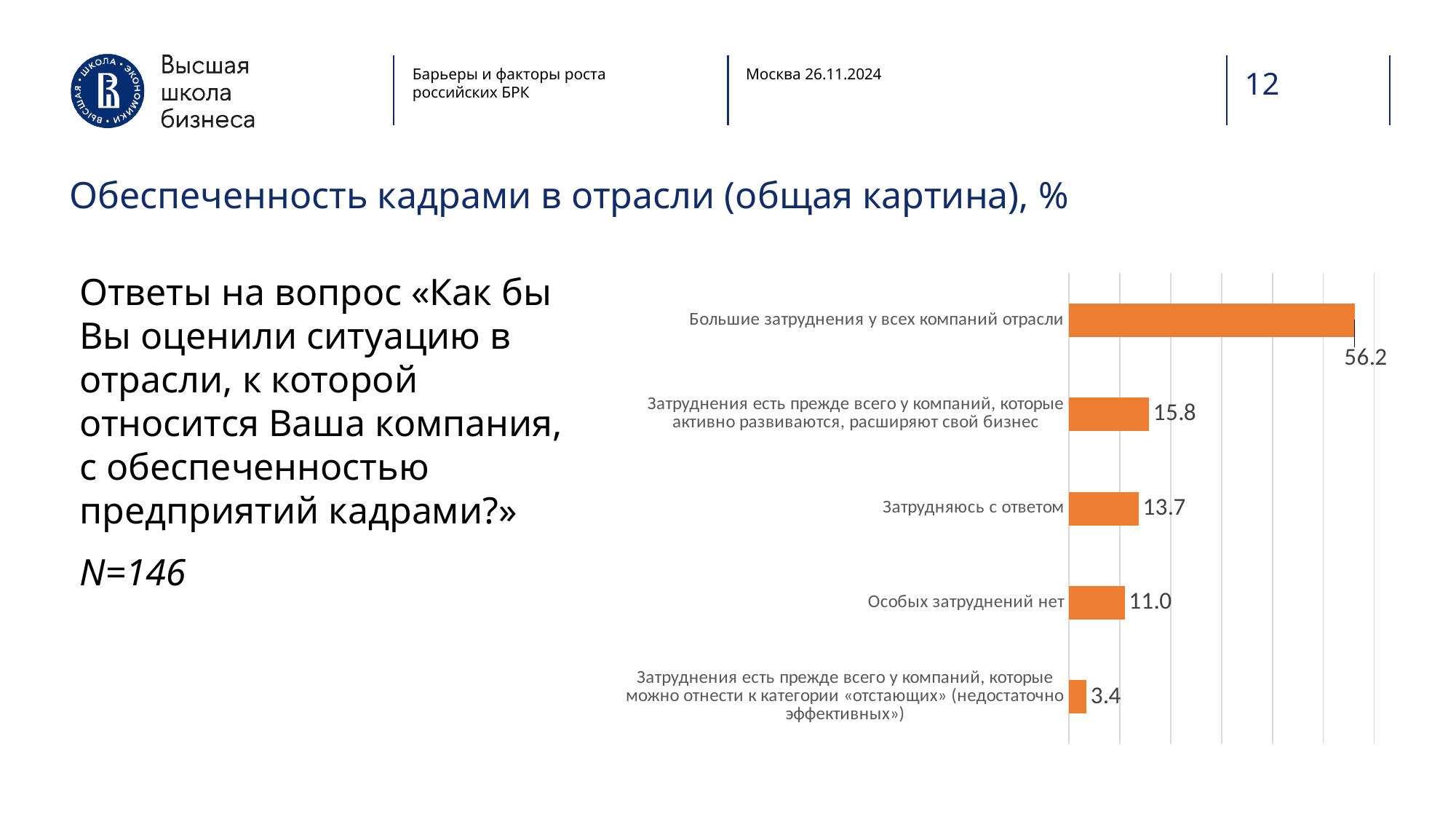
Which category has the highest value? Большие затруднения у всех компаний отрасли What is the difference between the values for «Затрудняюсь с ответом» and «Затруднения есть прежде всего у компаний, которые можно отнести к категории «отстающих» (недостаточно эффективных)»? 10.3 What kind of chart is shown on the slide? Bar chart What is the value for «Затрудняюсь с ответом»? 13.7 What is the sample size (N) stated on the slide? N=146 What is the value for «Большие затруднения у всех компаний отрасли»? 56.2 What is the difference between the values for «Большие затруднения у всех компаний отрасли» and «Особых затруднений нет»? 45.2 What is the value for «Особых затруднений нет»? 11.0 Which category has the lowest value? Затруднения есть прежде всего у компаний, которые можно отнести к категории «отстающих» (недостаточно эффективных) Which is larger: the value for «Затрудняюсь с ответом» or for «Особых затруднений нет»? Затрудняюсь с ответом What is the value for «Затруднения есть прежде всего у компаний, которые активно развиваются, расширяют свой бизнес»? 15.8 How many categories are shown in the chart? 5